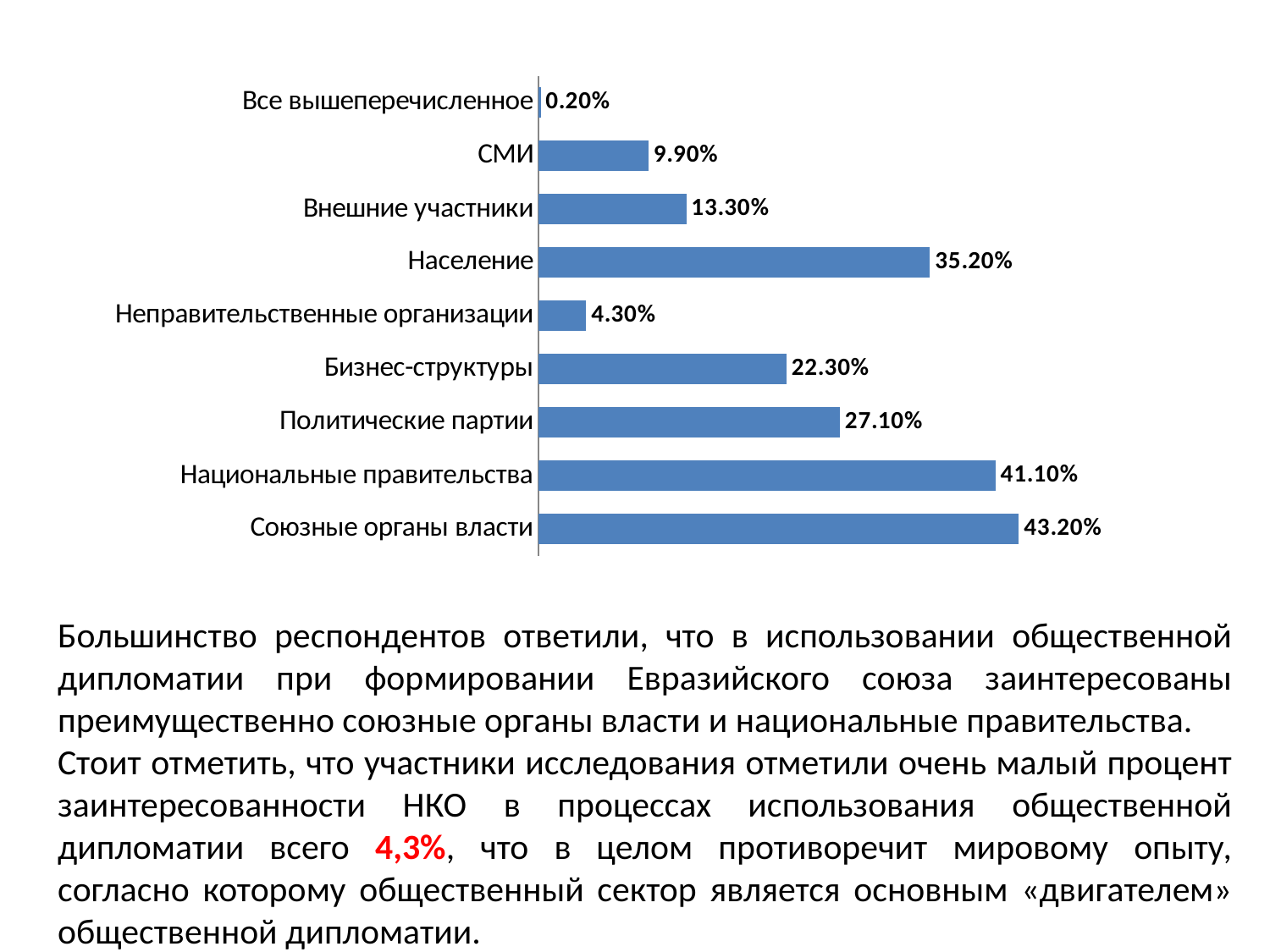
Which is larger, the value for Внешние участники or the value for СМИ? Внешние участники Which category has the highest value? Союзные органы власти What is the value for СМИ? 9.90% Which is larger, the value for Население or the value for Политические партии? Население What is the value for Неправительственные организации? 4.30% What is the difference between the values for Политические партии and Бизнес-структуры? 4.80% What is the value for Население? 35.20% What is the value for Союзные органы власти? 43.20% How many categories are shown in the chart? 9 Which category has the lowest value? Все вышеперечисленное What is the difference between the values for Союзные органы власти and Национальные правительства? 2.10% What kind of chart is shown on the slide? Bar chart